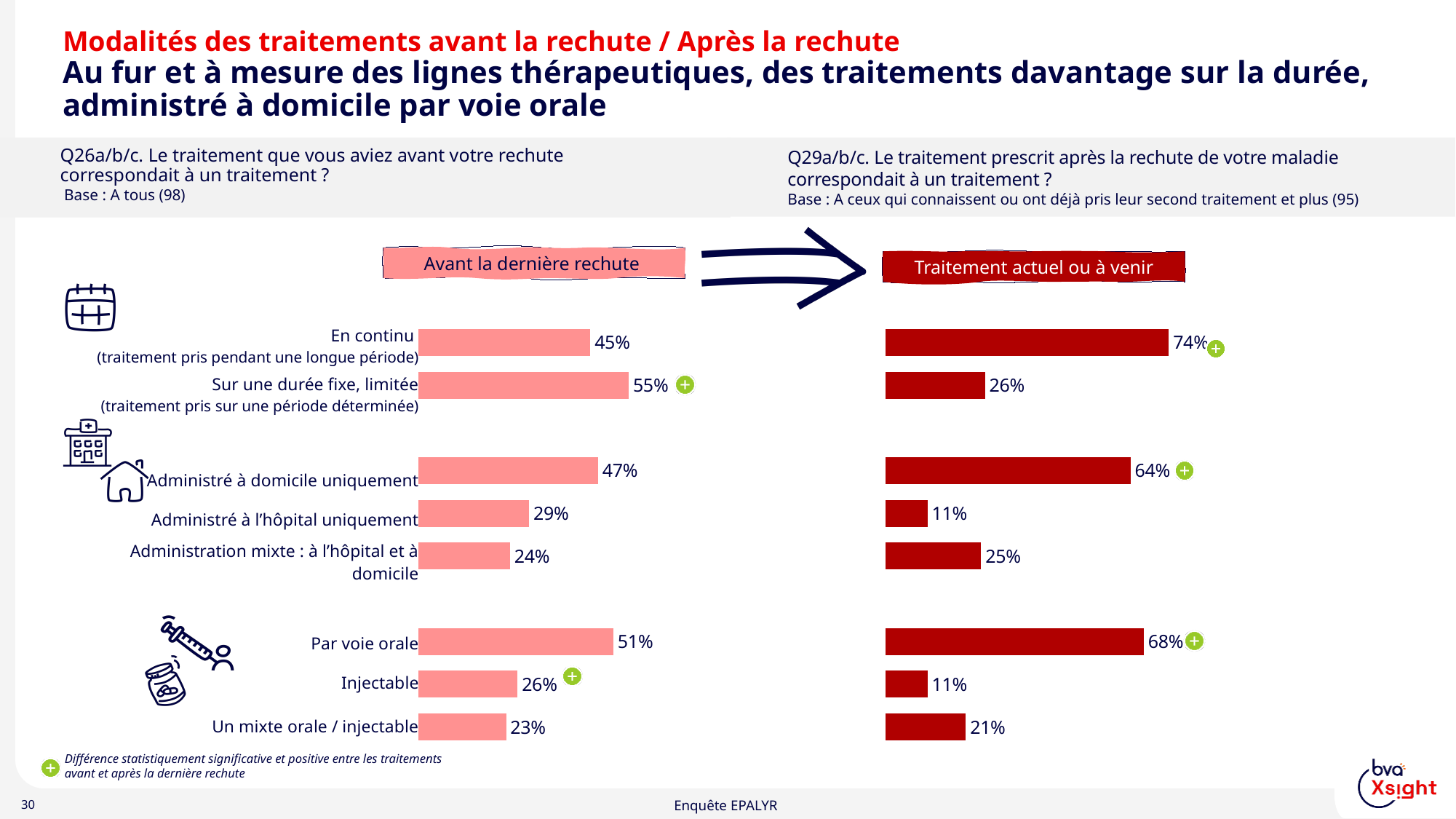
How many categories are shown in the 'Avant la dernière rechute' chart? 8 In the 'Avant la dernière rechute' chart, which category has the highest value? Sur une durée fixe, limitée In the 'Avant la dernière rechute' chart, which category has the lowest value? Un mixte orale / injectable What is the difference between the 'Par voie orale' values in the 'Traitement actuel ou à venir' chart and the 'Avant la dernière rechute' chart? 17 percentage points In the 'Avant la dernière rechute' chart, what is the value for 'Administration mixte : à l'hôpital et à domicile'? 24% In the 'Traitement actuel ou à venir' chart, what is the value for 'Administré à l'hôpital uniquement'? 11% What type of chart is used on this slide? Bar chart In the 'Traitement actuel ou à venir' chart, what is the value for 'En continu'? 74% In the 'Avant la dernière rechute' chart, what is the value for 'Par voie orale'? 51% In the 'Traitement actuel ou à venir' chart, which category has the highest value? En continu Which is larger: 'Injectable' in the 'Avant la dernière rechute' chart or 'Injectable' in the 'Traitement actuel ou à venir' chart? Avant la dernière rechute In the 'Traitement actuel ou à venir' chart, what is the difference between 'Administré à domicile uniquement' and 'Administration mixte : à l'hôpital et à domicile'? 39 percentage points